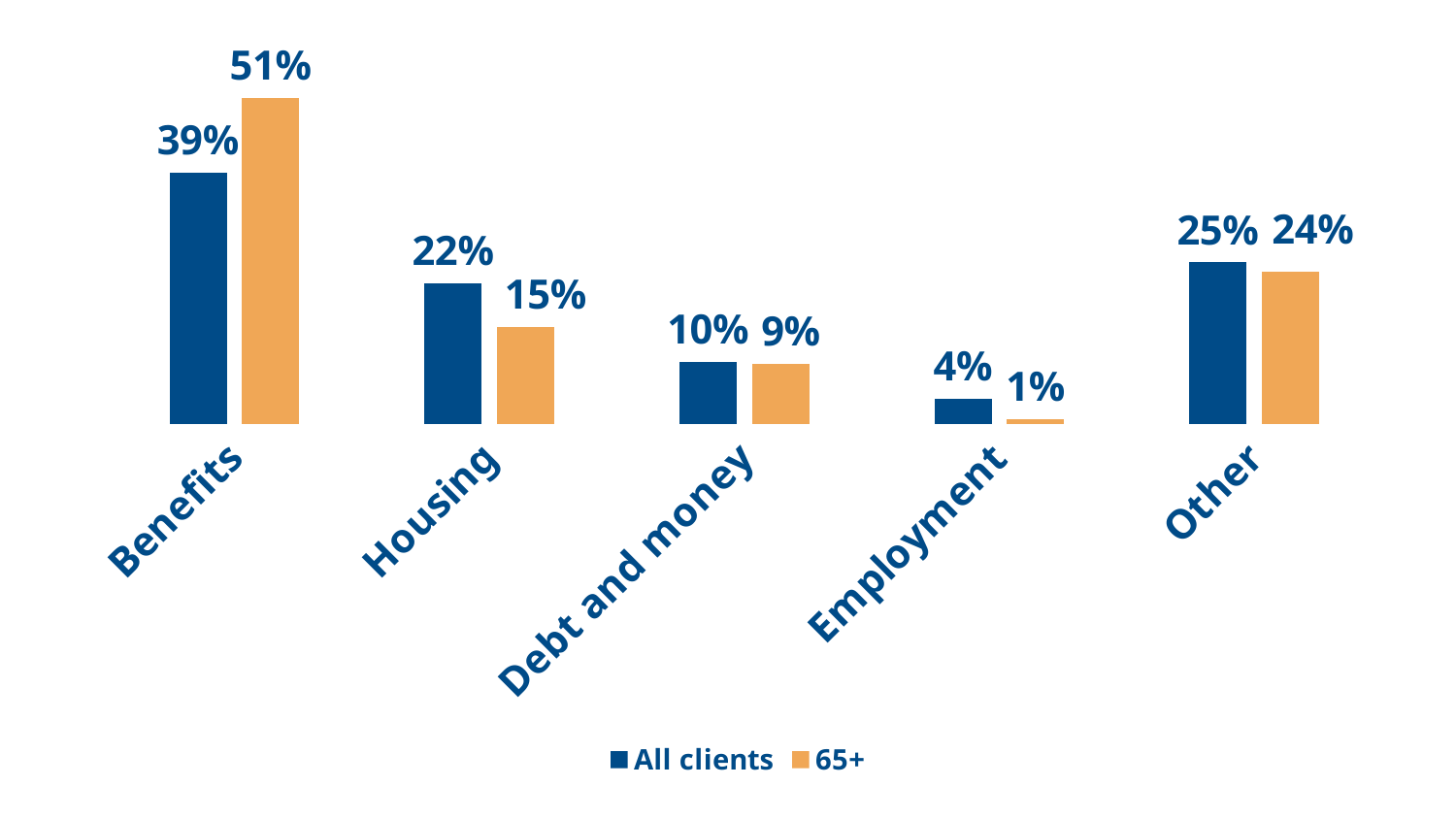
What is the difference between the All clients and 65+ values for Housing? 7% Which category has the lowest value in the All clients series? Employment What is the value for Employment in the 65+ series? 1% How many categories are shown on the x axis? 5 What kind of chart is shown on the slide? Bar chart How many series does the legend list? 2 What is the value for Other in the All clients series? 25% What is the value for Benefits in the 65+ series? 51% Which is larger for Debt and money: the All clients value or the 65+ value? All clients What is the difference between the 65+ and All clients values for Benefits? 12% What is the value for Housing in the All clients series? 22% Which category has the highest value in the 65+ series? Benefits